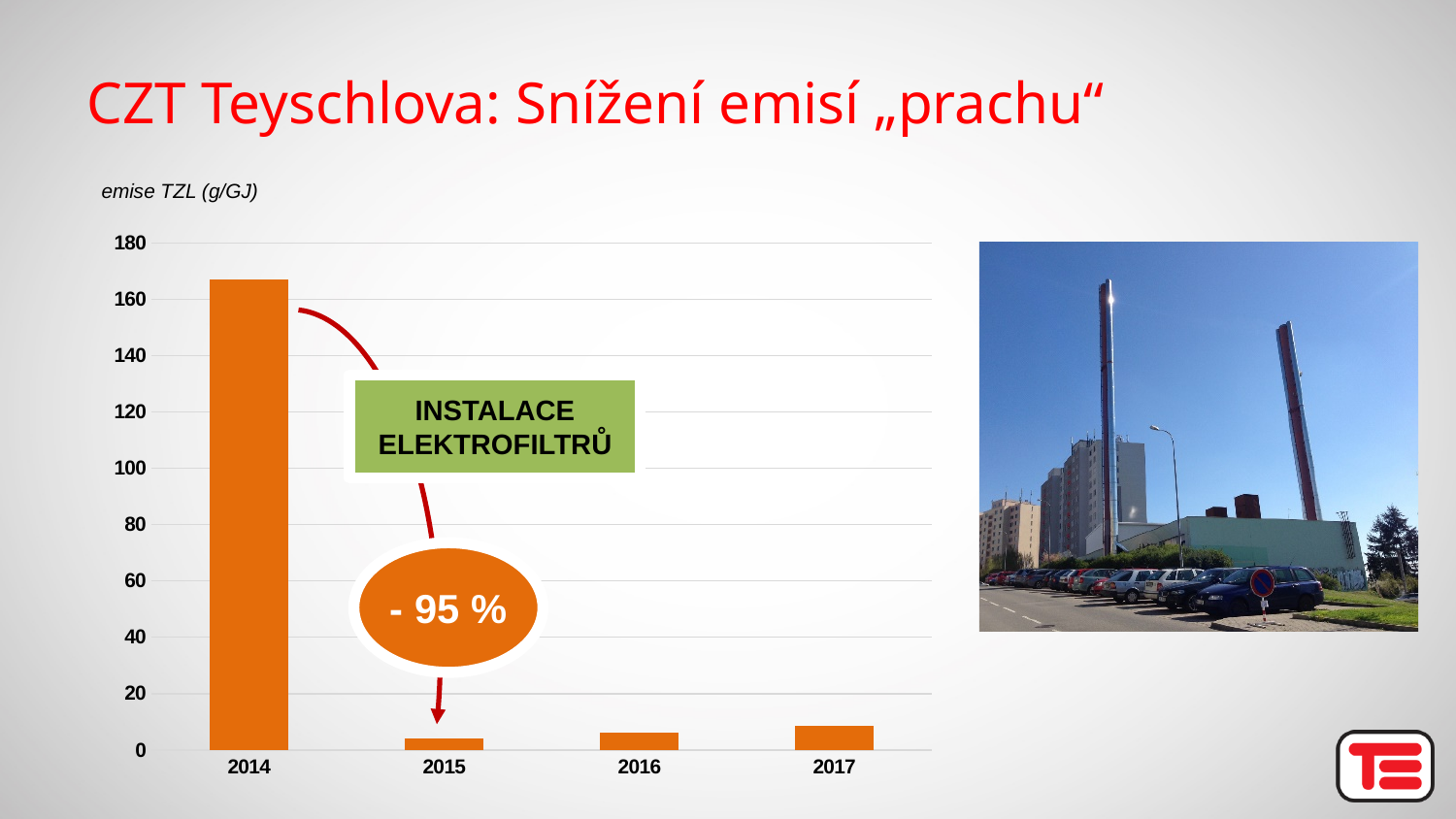
What percentage reduction is shown in the orange oval annotation on the chart? - 95 % Is the value for 2017 greater or less than 20? less What unit label is shown above the chart's y axis? emise TZL (g/GJ) What kind of chart is shown on the slide? bar chart Do the values rise or fall from 2014 to 2015? fall Which is larger, the value for 2014 or the value for 2015? 2014 Is the value for 2014 greater or less than 180? less How many years (categories) are shown on the x axis of the chart? 4 Is the value for 2014 greater or less than 160? greater Which is larger, the value for 2015 or the value for 2017? 2017 Which year has the highest emission value in the chart? 2014